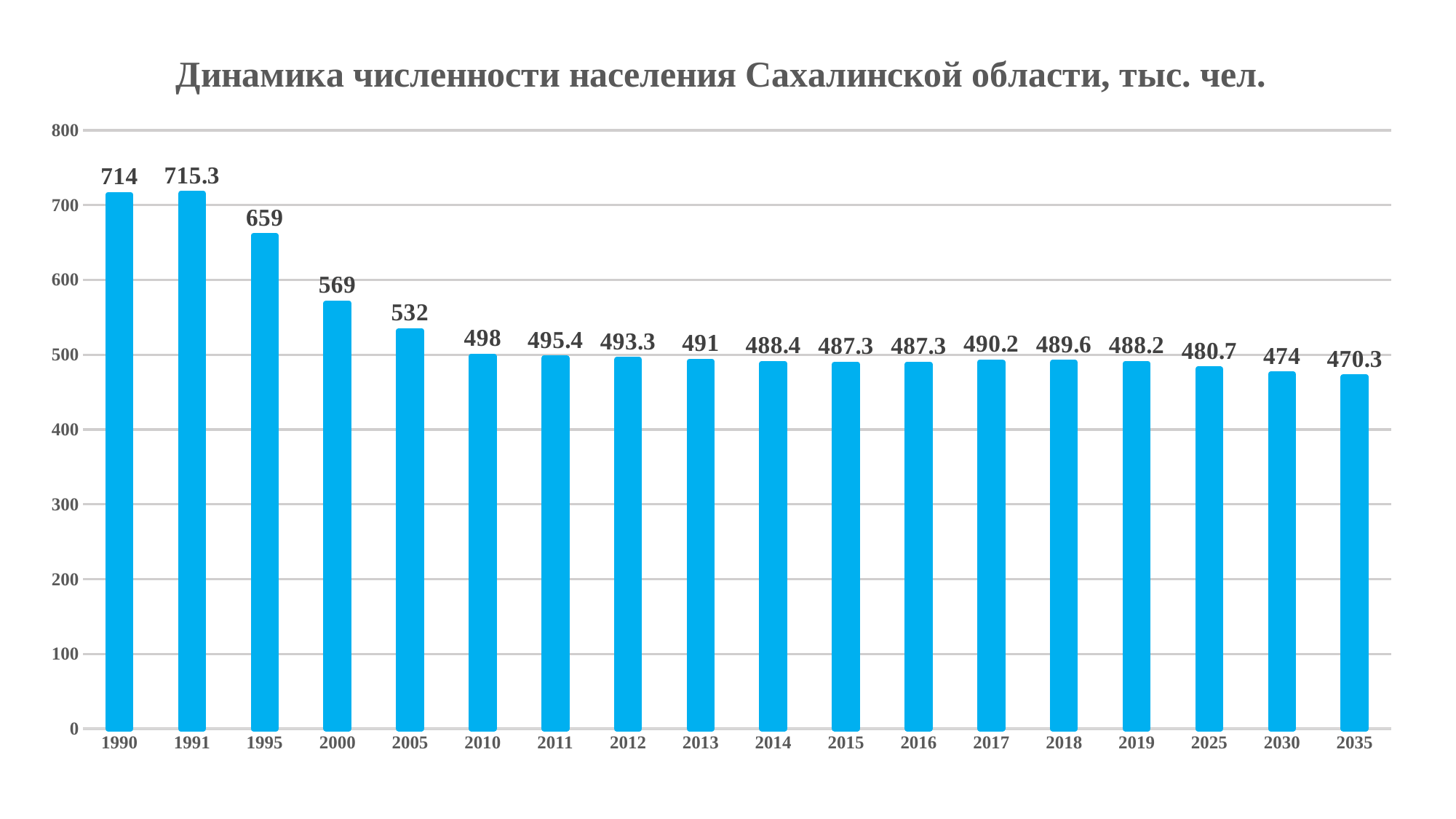
Which year has the highest value? 1991 What is the value for 2035? 470.3 Which is larger, the value for 2005 or the value for 2010? 2005 How many years are shown on the x axis? 18 What kind of chart is this? bar chart What is the value for 2017? 490.2 Which year has the lowest value? 2035 What is the difference between the values for 2010 and 2035? 27.7 What is the difference between the values for 1990 and 2000? 145 Is the value for 2000 greater or less than 600? less Do the values generally rise or fall from 1991 to 2035? fall What is the value for 1995? 659